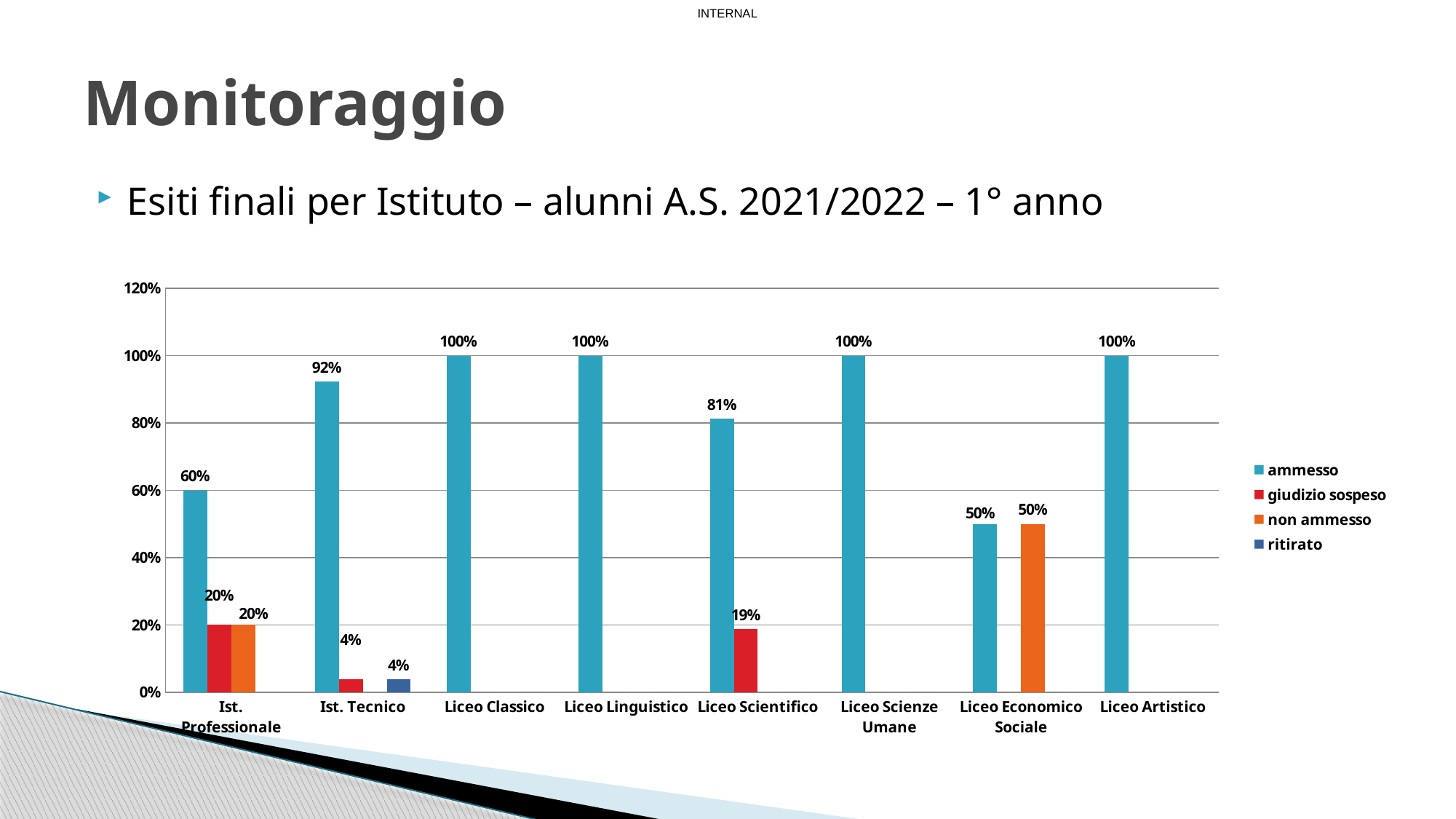
How many institutes are shown on the x axis? 8 Which legend entry is shown in orange? non ammesso How many institutes have an 'ammesso' value of 100%? 4 What is the 'non ammesso' value for Liceo Economico Sociale? 50% What is the difference between the 'ammesso' values for Ist. Tecnico and Liceo Scientifico? 11% What is the 'ritirato' value for Ist. Tecnico? 4% Which institute has the lowest 'ammesso' value? Liceo Economico Sociale What is the 'ammesso' value for Ist. Professionale? 60% What is the 'giudizio sospeso' value for Liceo Scientifico? 19% How many series does the legend list? 4 Which is larger, the 'ammesso' value for Ist. Professionale or for Ist. Tecnico? Ist. Tecnico What kind of chart is shown on the slide? Bar chart